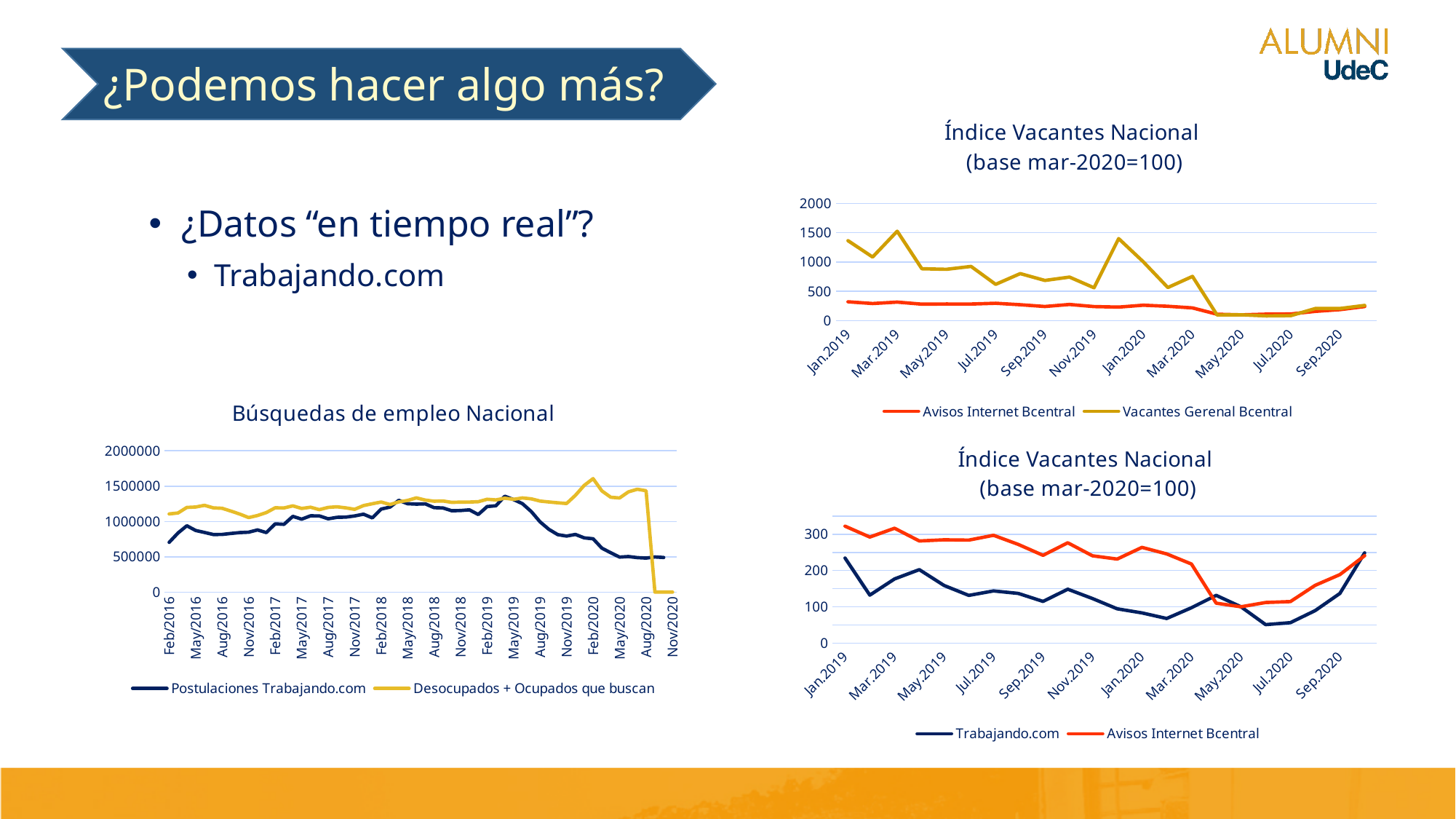
In the top-right 'Índice Vacantes Nacional' chart, is the value for Vacantes Gerenal Bcentral in Mar.2019 greater or less than 1000? greater How many series does the legend of the 'Búsquedas de empleo Nacional' chart list? 2 What kind of chart is the 'Búsquedas de empleo Nacional' chart? Line chart In the top-right 'Índice Vacantes Nacional' chart, is the value for Avisos Internet Bcentral in Jan.2019 greater or less than 500? less In the 'Búsquedas de empleo Nacional' chart, is the value for Postulaciones Trabajando.com in Feb/2016 greater or less than 1000000? less In the bottom-right 'Índice Vacantes Nacional' chart, what are the two legend entries? Trabajando.com and Avisos Internet Bcentral In the top-right 'Índice Vacantes Nacional' chart, how many series does the legend list? 2 In the 'Búsquedas de empleo Nacional' chart, which series has the higher value in Feb/2016? Desocupados + Ocupados que buscan In the bottom-right 'Índice Vacantes Nacional' chart, does the Trabajando.com series rise or fall overall from Jan.2019 to Jul.2020? Fall In the top-right 'Índice Vacantes Nacional' chart, which series has the higher value in Jan.2019? Vacantes Gerenal Bcentral